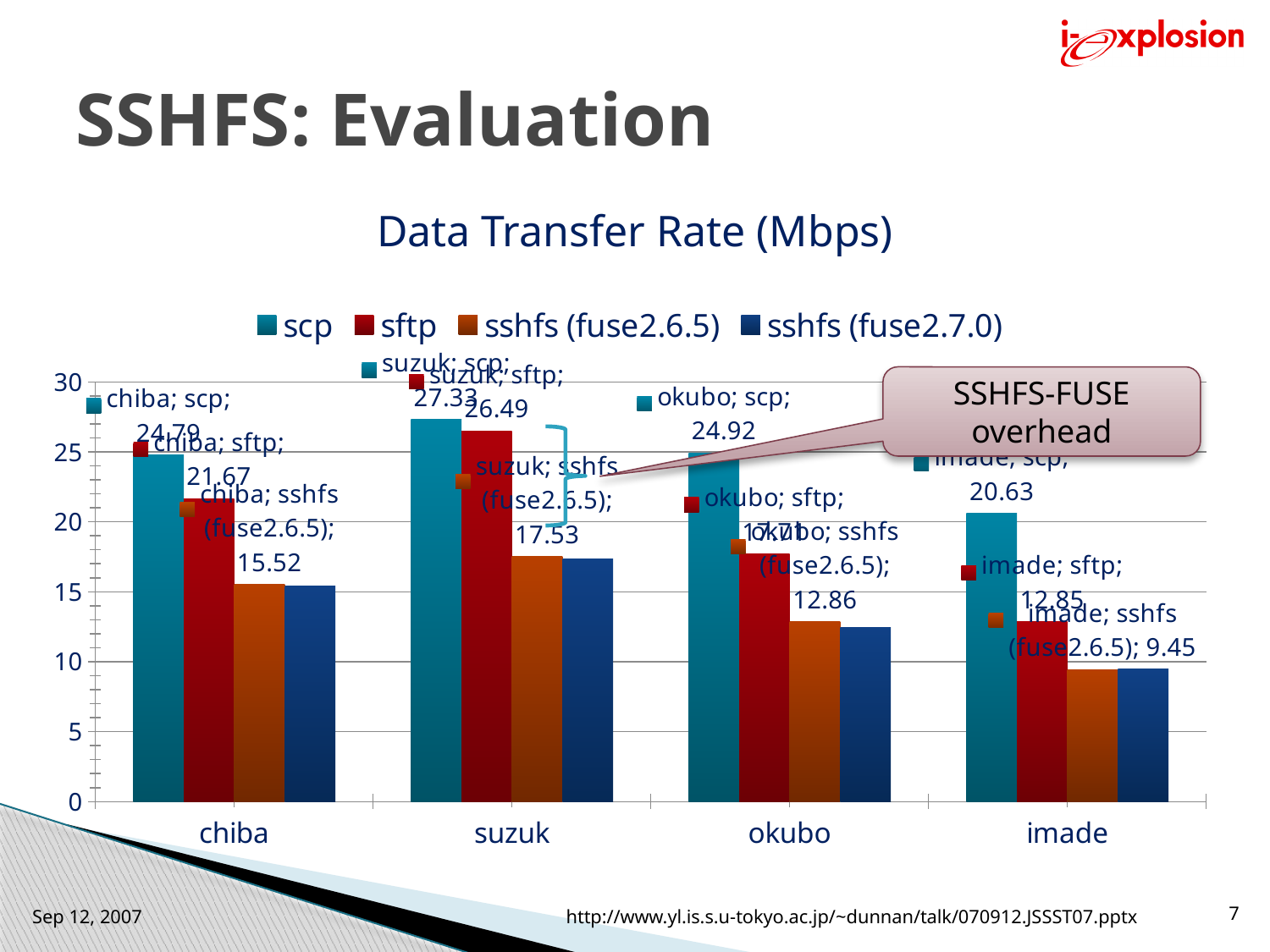
What kind of chart is shown on the slide? bar chart What is the title of the chart? Data Transfer Rate (Mbps) What is the sshfs (fuse2.6.5) data transfer rate for imade? 9.45 What is the scp data transfer rate for suzuk? 27.33 How many series does the legend list? 4 How many categories are shown on the x axis? 4 What is the scp data transfer rate for okubo? 24.92 What is the sftp data transfer rate for chiba? 21.67 Which category has the highest scp data transfer rate? suzuk Which category has the lowest scp data transfer rate? imade What is the difference between the scp and sftp data transfer rates for suzuk? 0.84 Is the sshfs (fuse2.7.0) value for chiba greater or less than 20? less